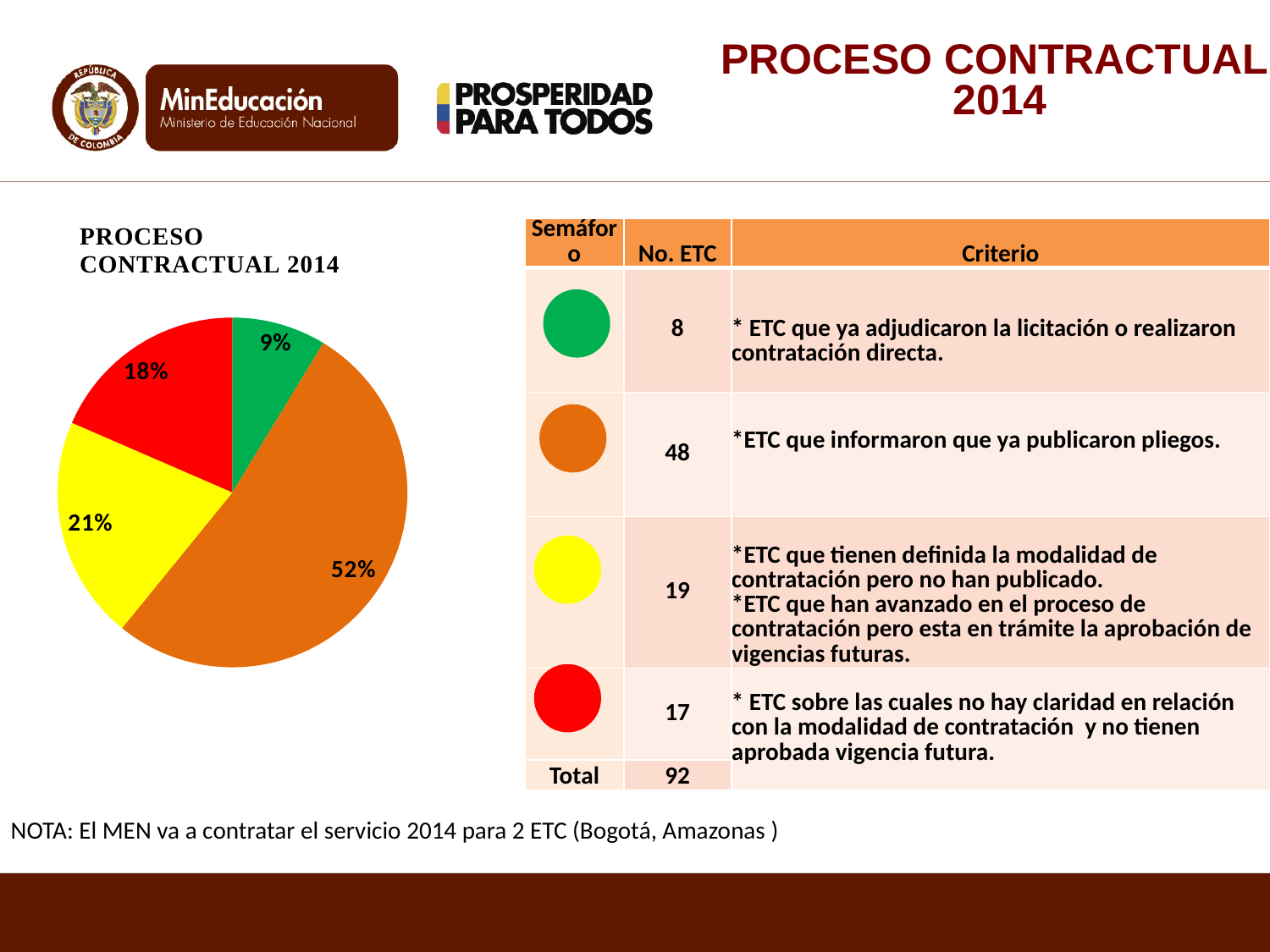
What is the difference in percentage points between the orange slice and the yellow slice of the pie chart? 31 What percentage is shown for the yellow slice of the pie chart? 21% What percentage is shown for the red slice of the pie chart? 18% What is the title of the pie chart? PROCESO CONTRACTUAL 2014 How many slices does the pie chart have? 4 Which colour slice is the largest in the pie chart? orange What percentage is shown for the green slice of the pie chart? 9% What is the difference in percentage points between the red slice and the green slice of the pie chart? 9 What percentage is shown for the orange slice of the pie chart? 52% Which slice is larger in the pie chart, the yellow slice or the red slice? yellow What kind of chart is shown on the slide? pie chart Which colour slice is the smallest in the pie chart? green